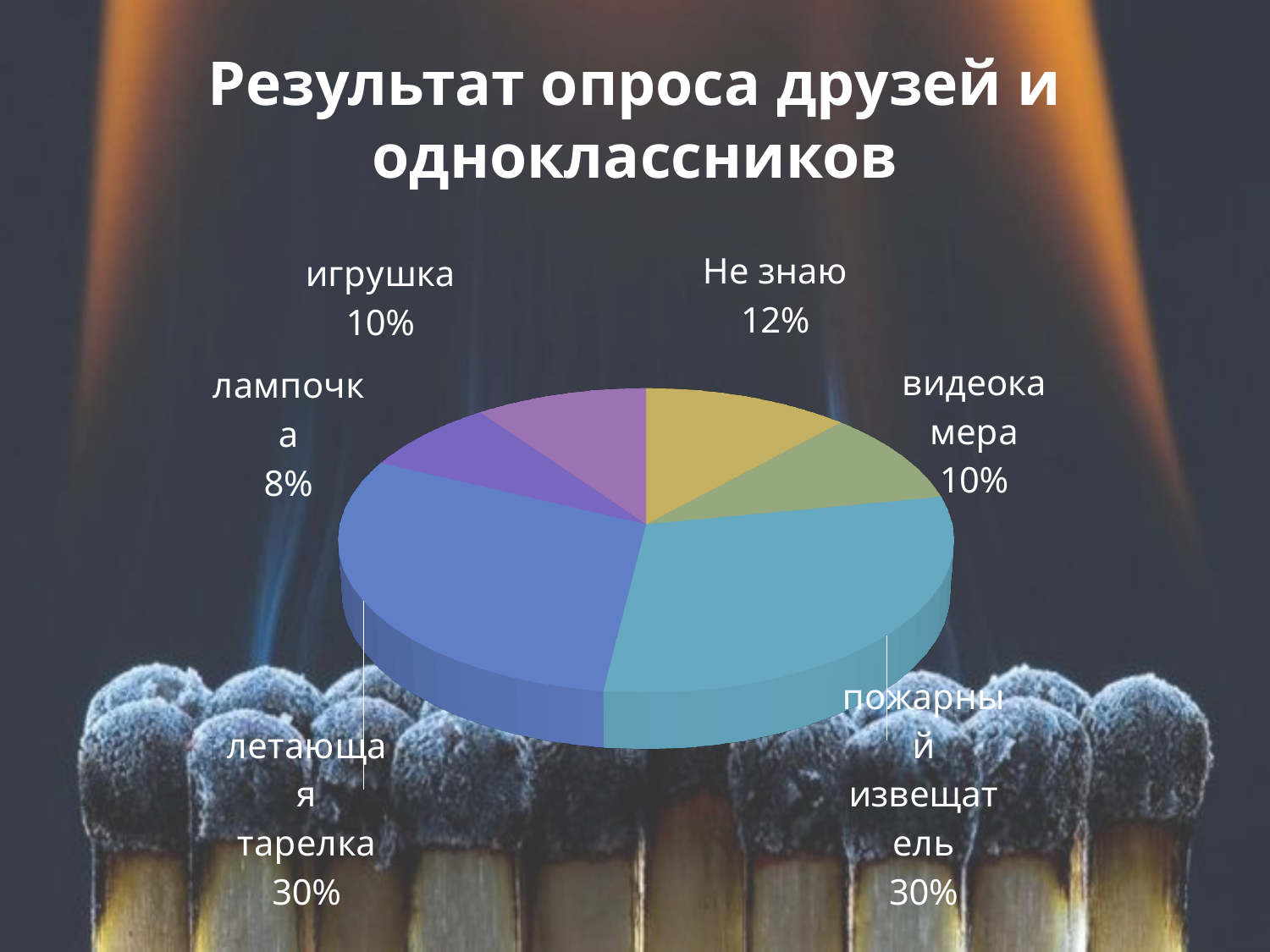
What share of the pie does "пожарный извещатель" have? 30% What is the difference between the share for "летающая тарелка" and the share for "лампочка"? 22% Which two categories share the same largest value of 30%? летающая тарелка and пожарный извещатель What share of the pie does "лампочка" have? 8% What share of the pie does "летающая тарелка" have? 30% Which category has the smallest share of the pie? лампочка How many categories are shown in the pie chart? 6 What share of the pie does "Не знаю" have? 12% What kind of chart is shown on the slide? pie chart What is the title of the slide containing the chart? Результат опроса друзей и одноклассников Which is larger: the share for "Не знаю" or the share for "игрушка"? Не знаю What share of the pie does "видеокамера" have? 10%